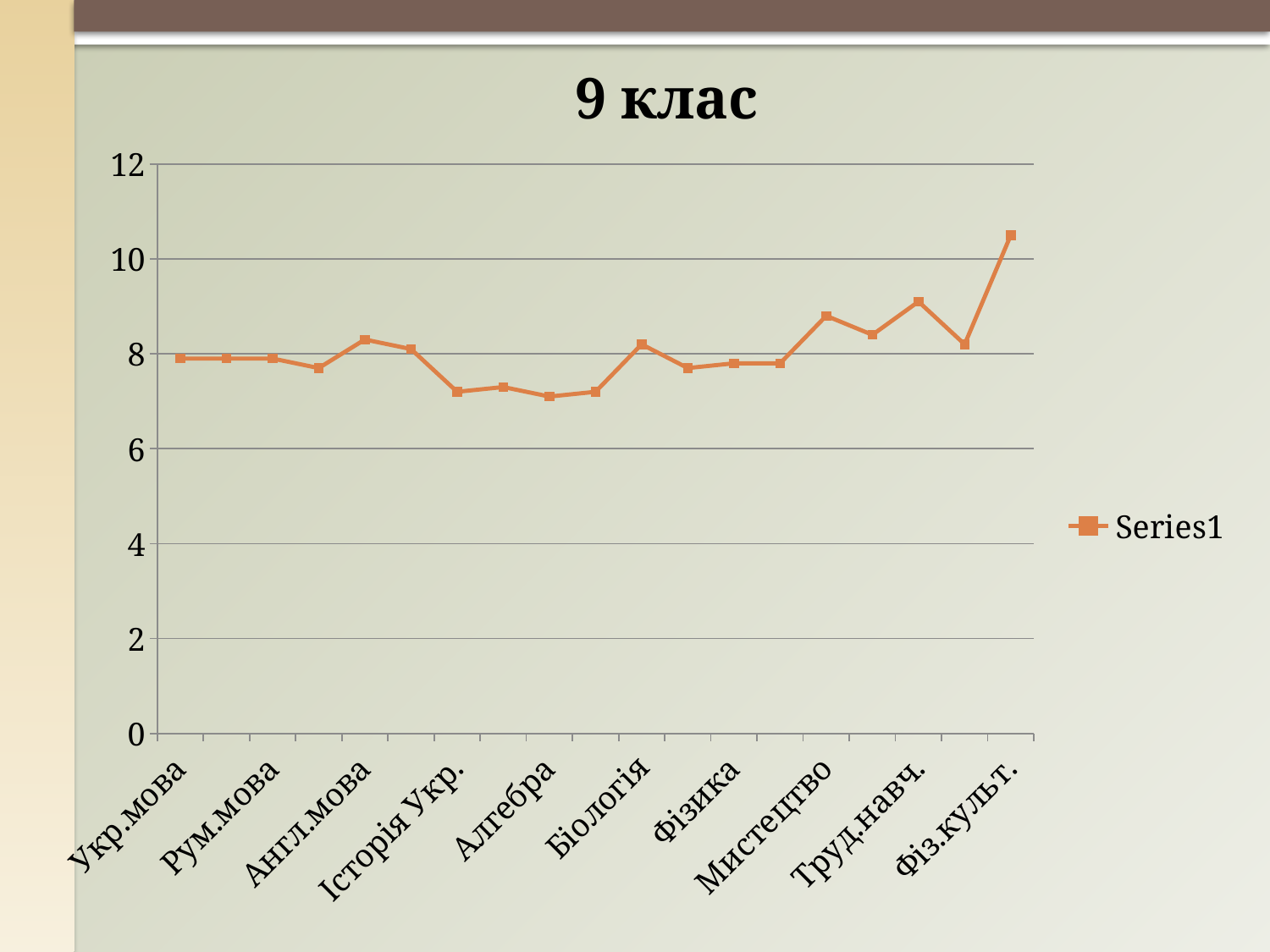
Is the value for Труд.навч. greater or less than 8? greater How many series does the legend list? 1 Which is larger, the value for Мистецтво or the value for Алгебра? Мистецтво Is the value for Фіз.культ. greater or less than 10? greater What is the title of the chart? 9 клас What kind of chart is shown on the slide? line chart Overall, do the values rise or fall from Укр.мова on the left to Фіз.культ. on the right? rise Is the value for Історія Укр. greater or less than 8? less Which category has the highest value? Фіз.культ. Which is larger, the value for Фіз.культ. or the value for Укр.мова? Фіз.культ. What is the name of the series shown in the legend? Series1